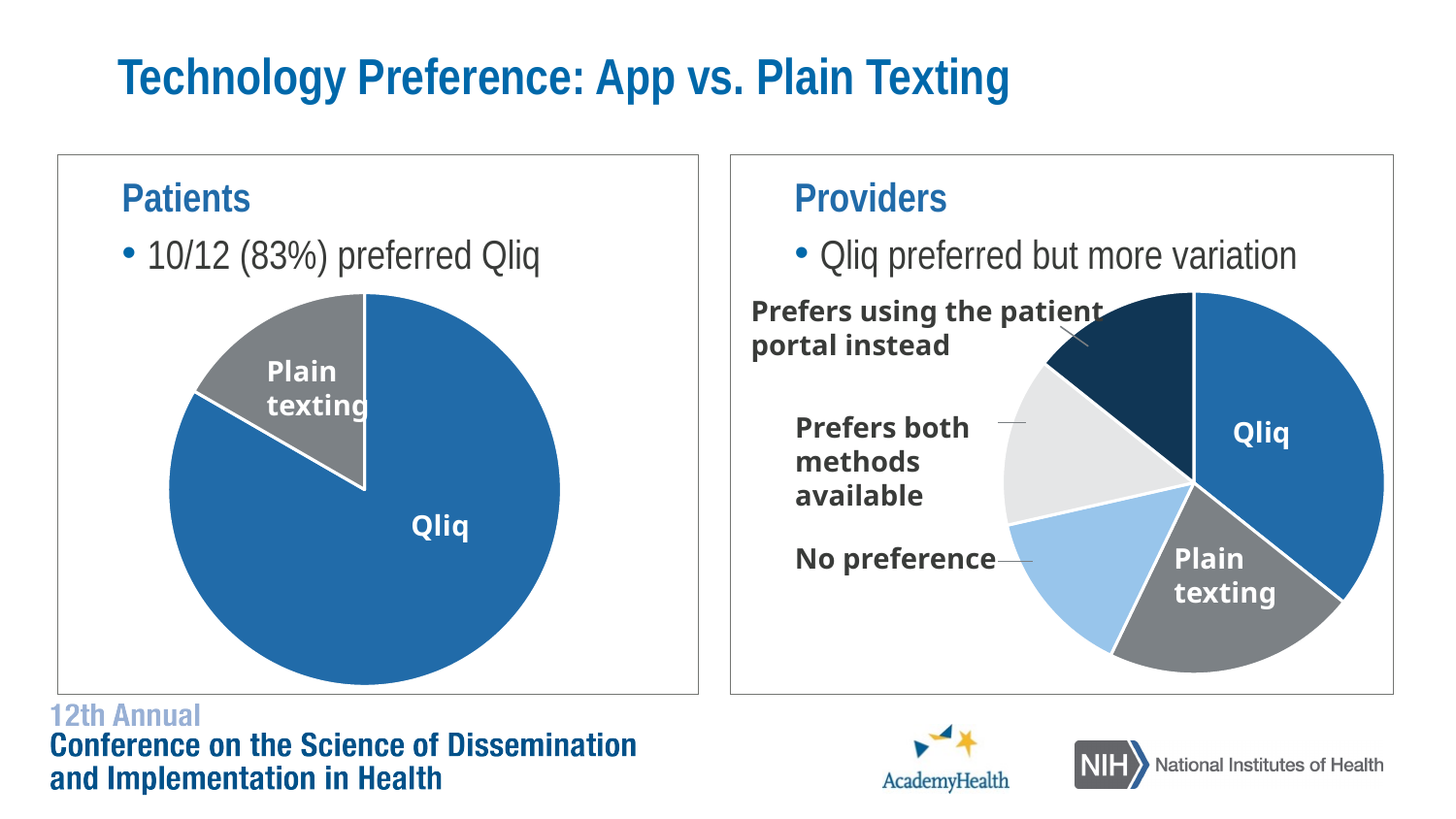
In the Patients chart, how many slices does the pie have? 2 In the Providers chart, which category has the largest slice? Qliq What kind of chart is the Providers chart? pie chart In the Providers chart, which is larger, the Plain texting slice or the No preference slice? Plain texting In the Patients chart, what share of patients preferred Qliq? 83% In the Patients chart, which category has the smallest slice? Plain texting In the Providers chart, which is larger, the Qliq slice or the Plain texting slice? Qliq In the Providers chart, how many slices does the pie have? 5 In the Providers chart, which category is shown in the darkest navy slice? Prefers using the patient portal instead What kind of chart is the Patients chart? pie chart In the Providers chart, what colour is the Qliq slice? blue In the Patients chart, which category has the largest slice? Qliq